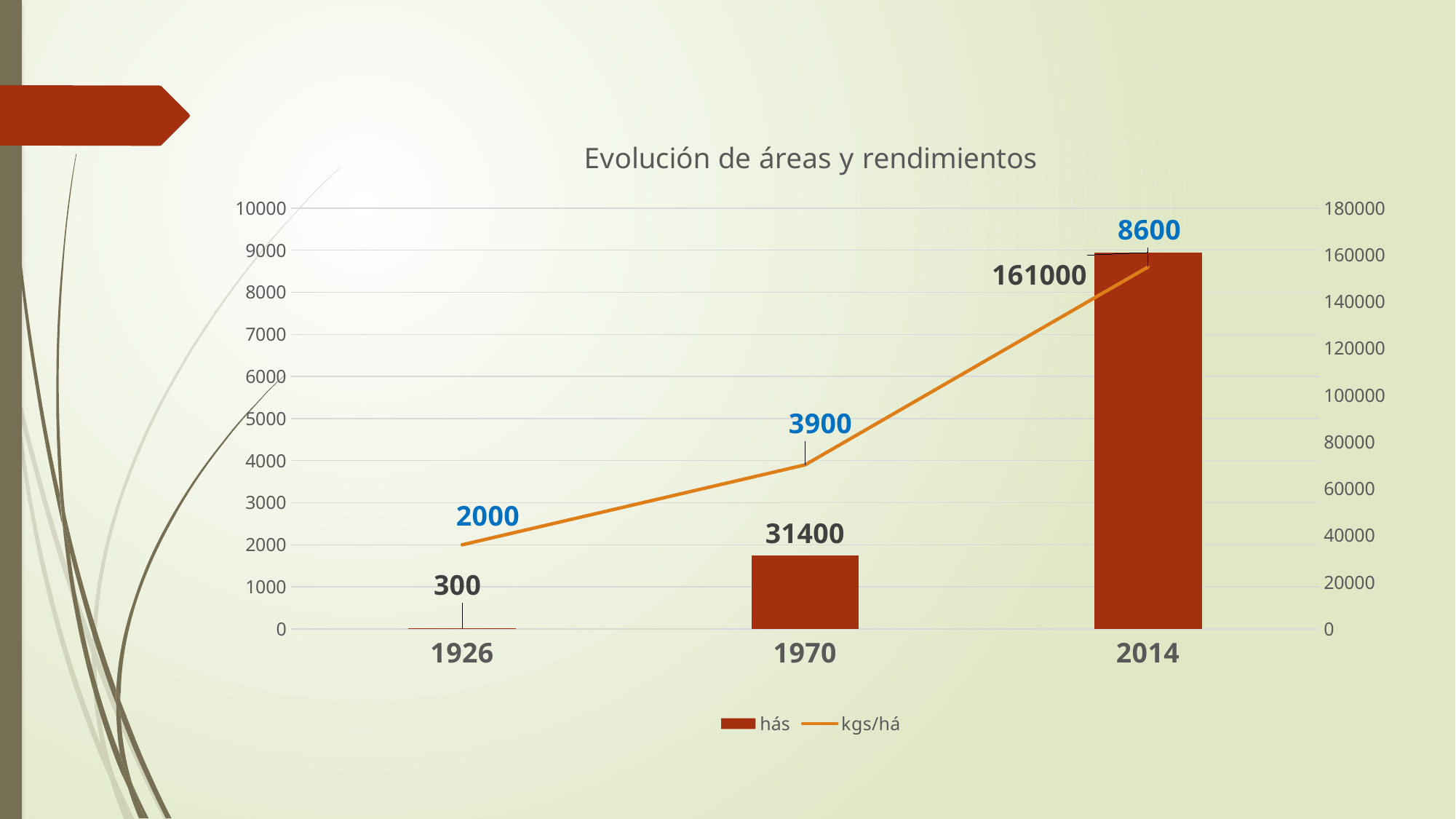
How many series does the legend list? 2 Which year has the highest value of hás? 2014 What is the value of kgs/há for 1970? 3900 What is the value of kgs/há for 1926? 2000 What is the value of hás for 1926? 300 What is the difference in hás between 2014 and 1970? 129600 Do the kgs/há values rise or fall from 1926 to 2014? rise Which is larger, the kgs/há value for 1970 or for 2014? 2014 Which year has the lowest value of kgs/há? 1926 What is the value of hás for 2014? 161000 What is the difference in kgs/há between 2014 and 1926? 6600 How many years are shown on the x axis? 3